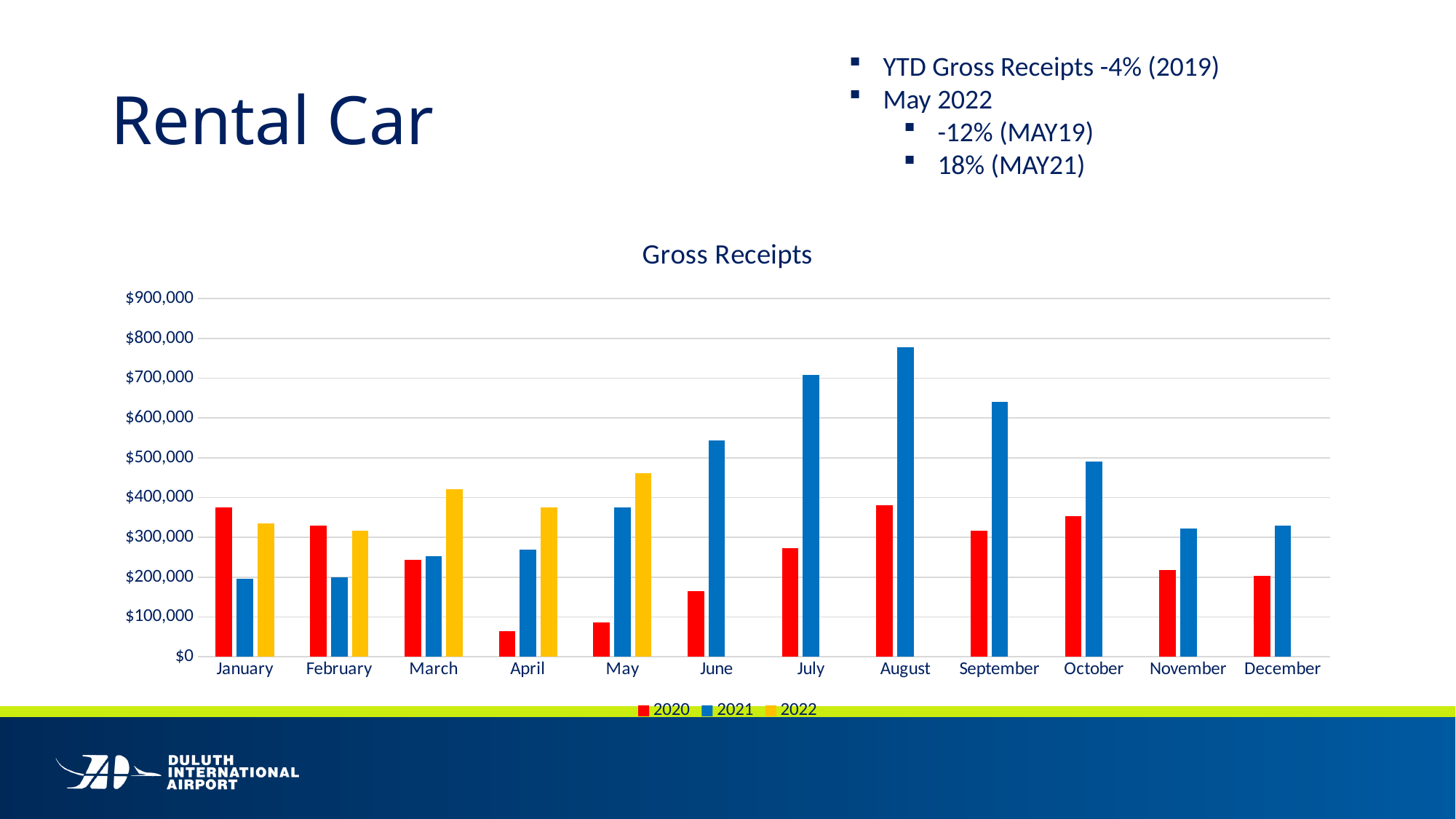
How many months are shown on the x axis of the Gross Receipts chart? 12 In which month is the 2020 gross receipts bar the lowest? April Do the 2021 values rise or fall from January to August? rise In January, which series has the larger value, 2020 or 2021? 2020 Is the 2020 value for April greater or less than $100,000? less How many series does the legend of the Gross Receipts chart list? 3 What kind of chart is shown on the slide? bar chart In May, which series has the larger value, 2021 or 2022? 2022 Is the 2021 value for July greater or less than $600,000? greater In which month is the 2021 gross receipts bar the highest? August In which month is the 2022 gross receipts bar the highest? May For how many months does the chart show a 2022 bar? 5